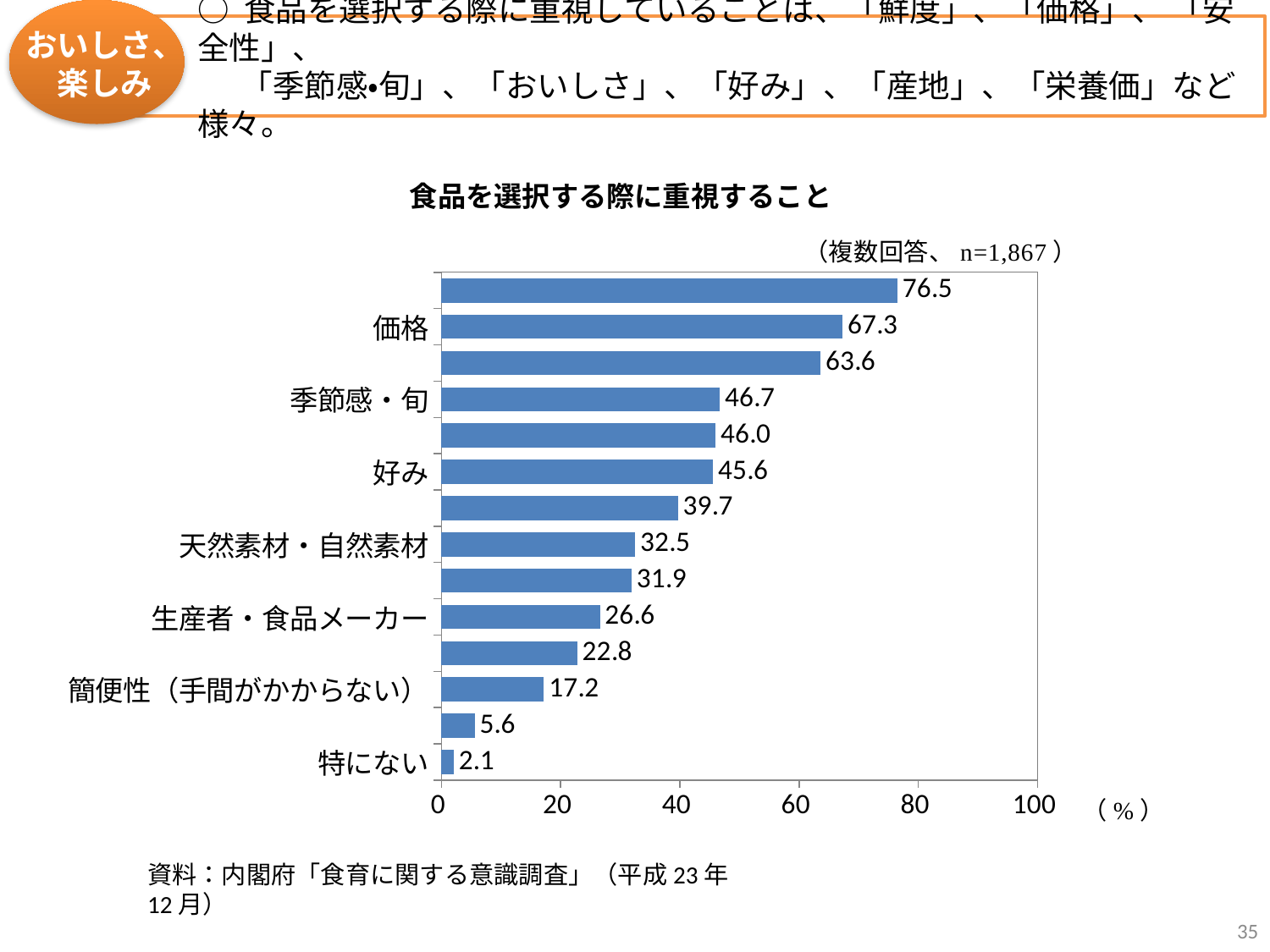
What is the value for 特にない? 2.1 What is the value for 季節感・旬? 46.7 What is the value of the longest bar in the chart? 76.5 What is the value for 価格? 67.3 How many bars are plotted in the chart? 14 Which labeled category has the lowest value? 特にない Which is larger, the value for 天然素材・自然素材 or the value for 生産者・食品メーカー? 天然素材・自然素材 What is the difference between the values for 価格 and 季節感・旬? 20.6 What is the title of the chart? 食品を選択する際に重視すること What is the value for 簡便性（手間がかからない）? 17.2 What sample size (n) is shown for the chart? n=1,867 What type of chart is shown on the slide? bar chart